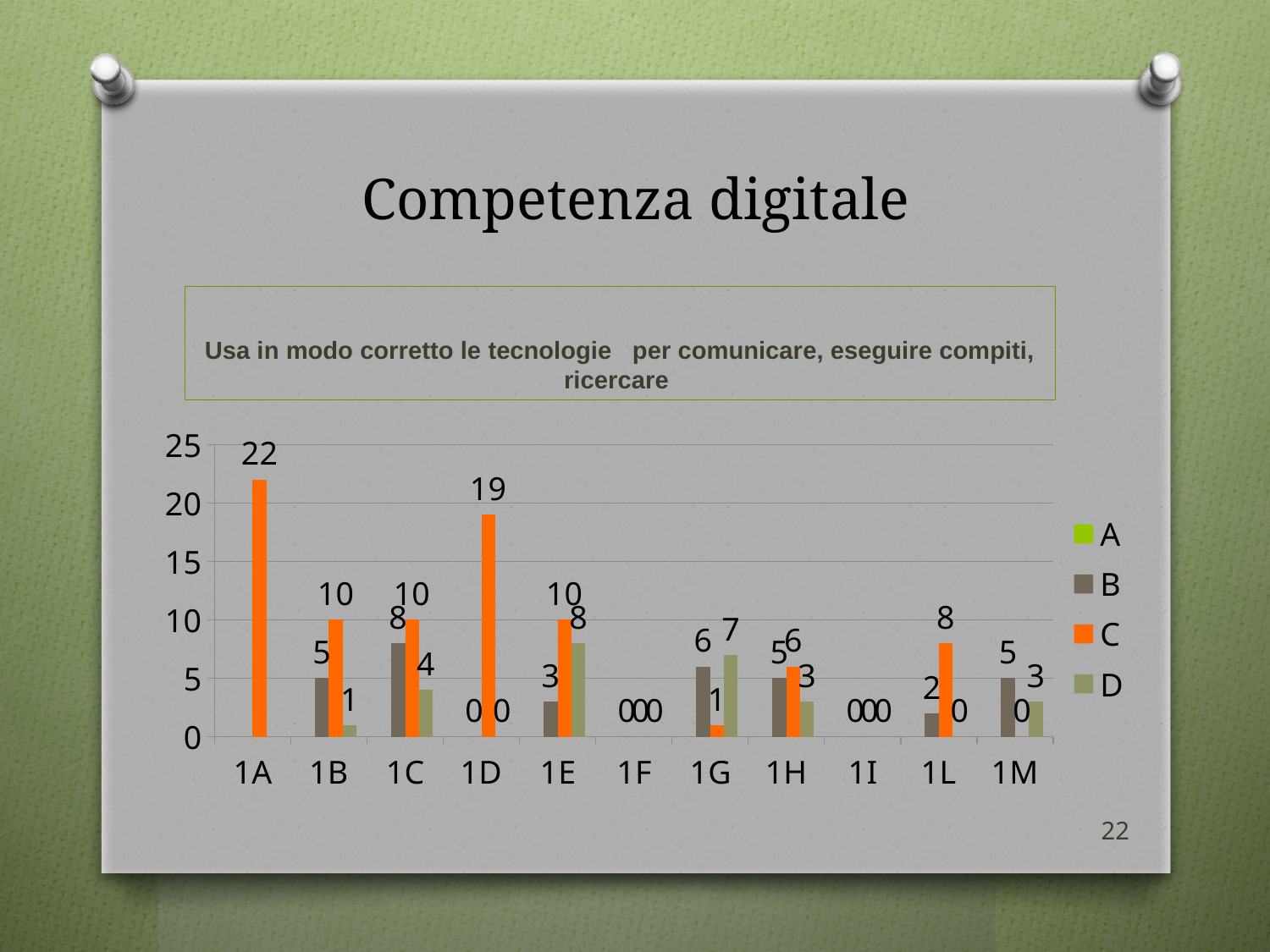
What is the value of series D for category 1E? 8 What is the value of series C for category 1D? 19 Which category has the highest value for series C? 1A How many series does the chart legend list? 4 What is the difference between the series D and series B values for category 1E? 5 What is the title of the slide containing the chart? Competenza digitale What is the difference between the series C values for 1A and 1D? 3 What is the value of series B for category 1G? 6 How many categories are shown on the x axis of the chart? 11 Which category has the larger series B value, 1B or 1C? 1C What kind of chart is shown on the slide? bar chart What is the value of series C for category 1A? 22